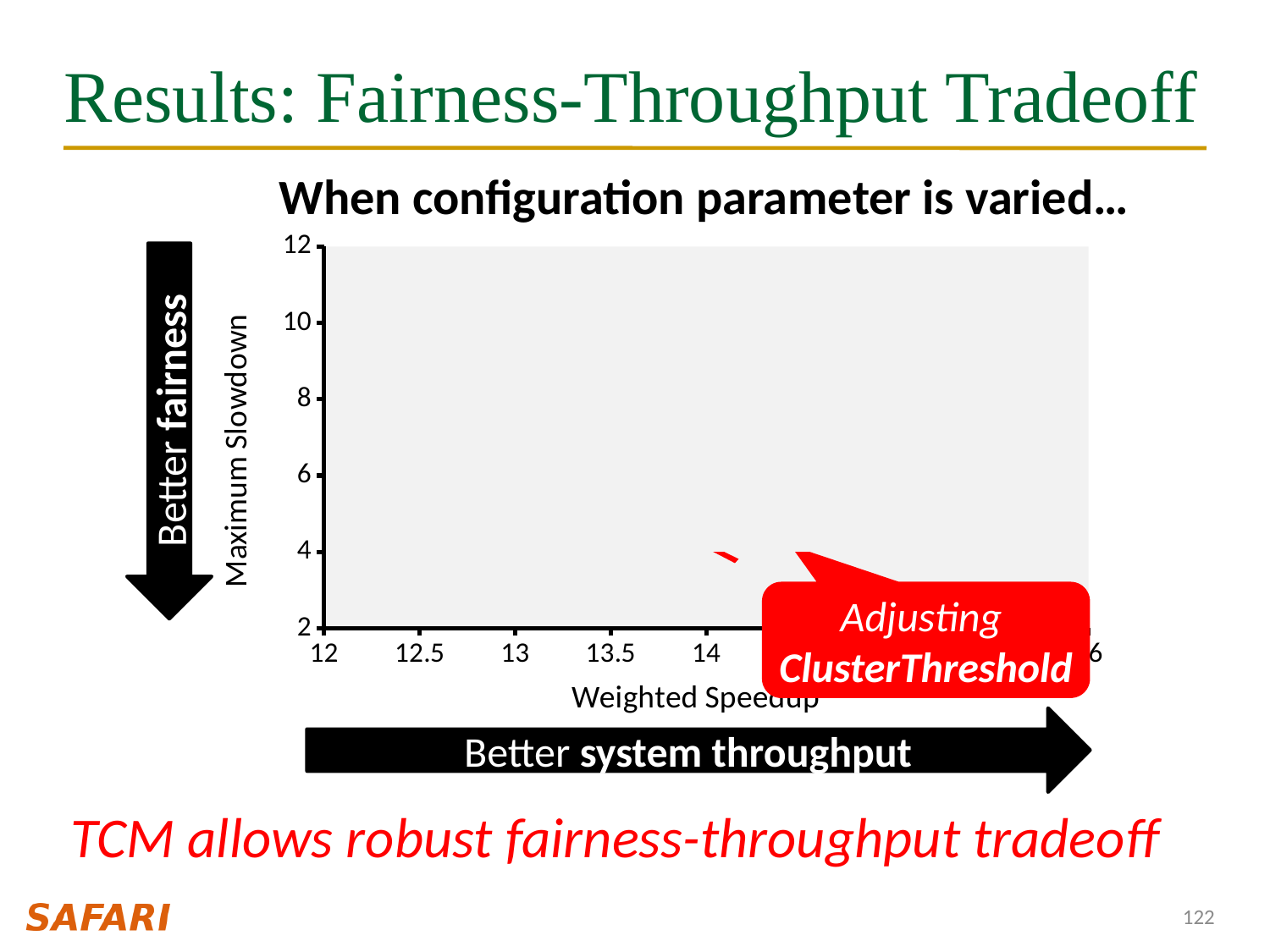
What kind of chart is shown on the slide? scatter chart What is the label of the vertical axis of the chart? Maximum Slowdown What is the title of the chart? When configuration parameter is varied… Is the Weighted Speedup of the red data point visible in the chart greater or less than 13? greater Is the Maximum Slowdown of the red data point visible near Weighted Speedup 14 greater or less than 6? less